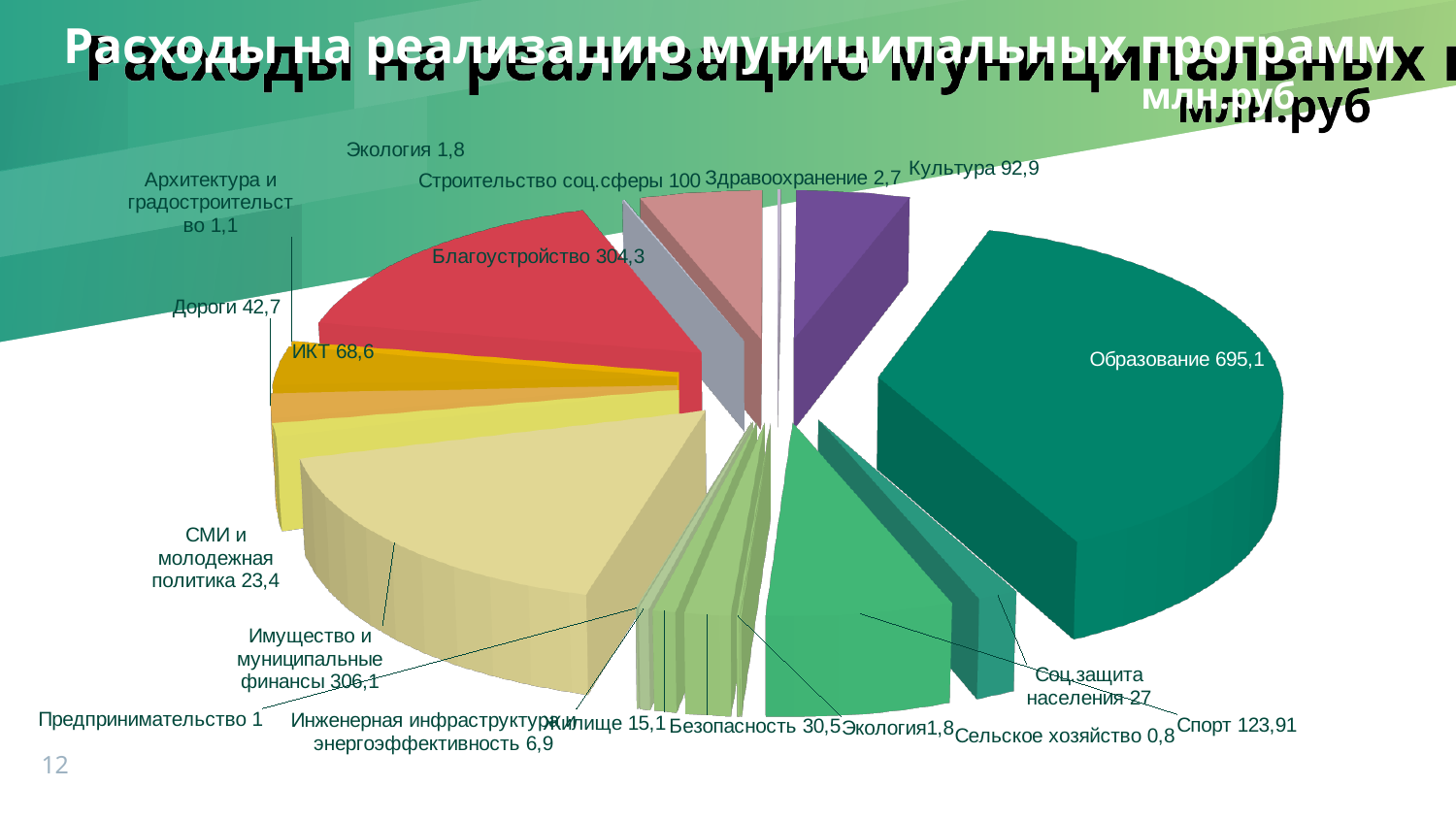
Which category has the highest value? Образование What is the value for Благоустройство? 304,3 What unit is stated for the values on the chart? млн.руб What is the value for Спорт? 123,91 Which is larger, Имущество и муниципальные финансы or Благоустройство? Имущество и муниципальные финансы What is the value for Строительство соц.сферы? 100 What kind of chart is shown on the slide? pie chart What is the value for Образование? 695,1 What is the value for Соц.защита населения? 27 What is the difference between Образование and Благоустройство? 390,8 Which category has the lowest value? Сельское хозяйство What is the difference between Спорт and Культура? 31,01